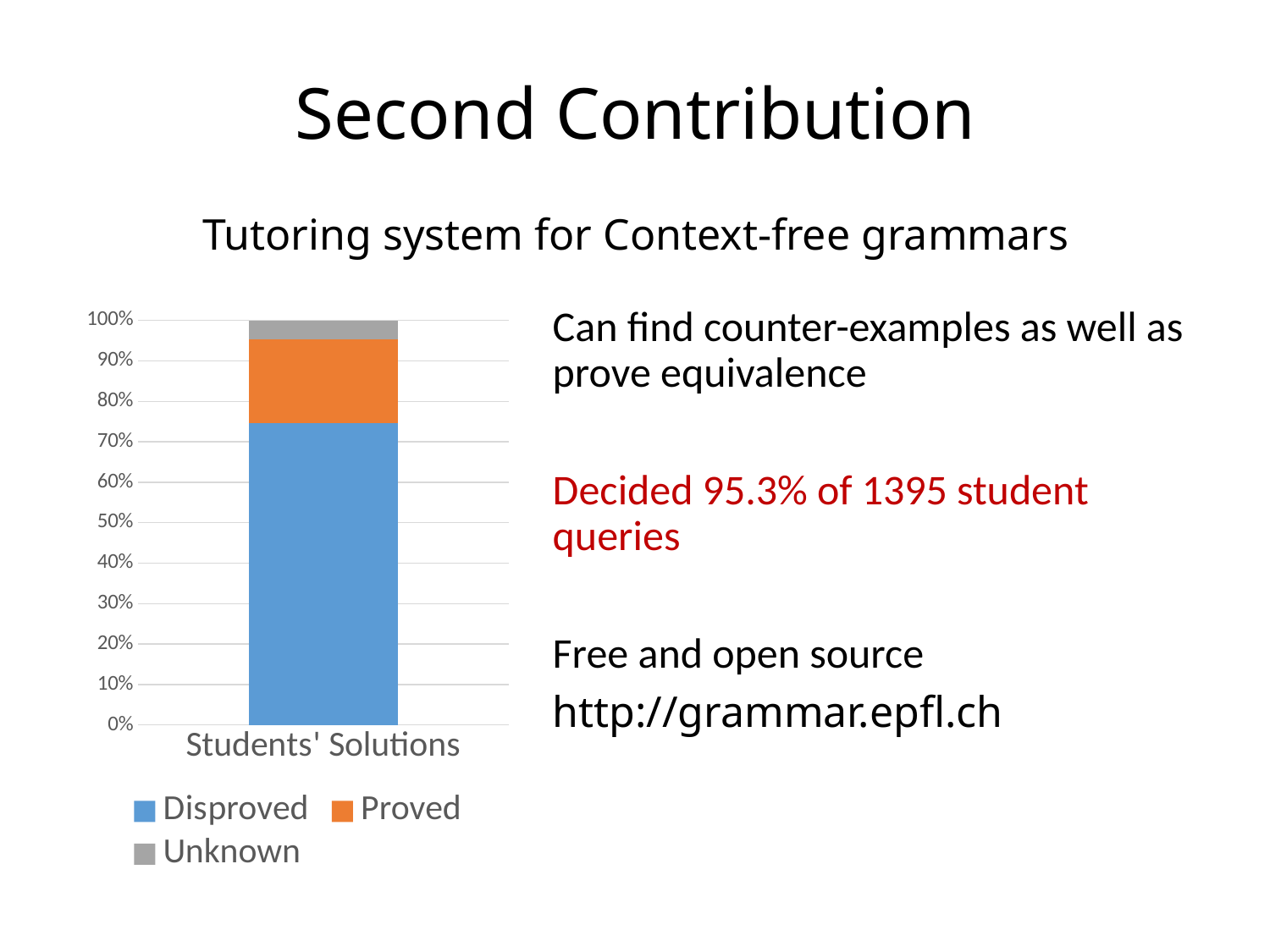
What is the label of the single category on the chart's x axis? Students' Solutions Which is larger in the Students' Solutions bar, the Proved segment or the Unknown segment? Proved Which series takes up the smallest share of the Students' Solutions bar? Unknown Which series takes up the largest share of the Students' Solutions bar? Disproved Which colour represents the Proved series in the chart? orange What kind of chart is shown on the slide? stacked bar chart Is the Unknown share of the Students' Solutions bar greater or less than 10%? less Is the Disproved share of the Students' Solutions bar greater or less than 70%? greater How many series does the chart's legend list? 3 Is the Disproved share of the Students' Solutions bar greater or less than 80%? less How many categories are plotted on the x axis of the chart? 1